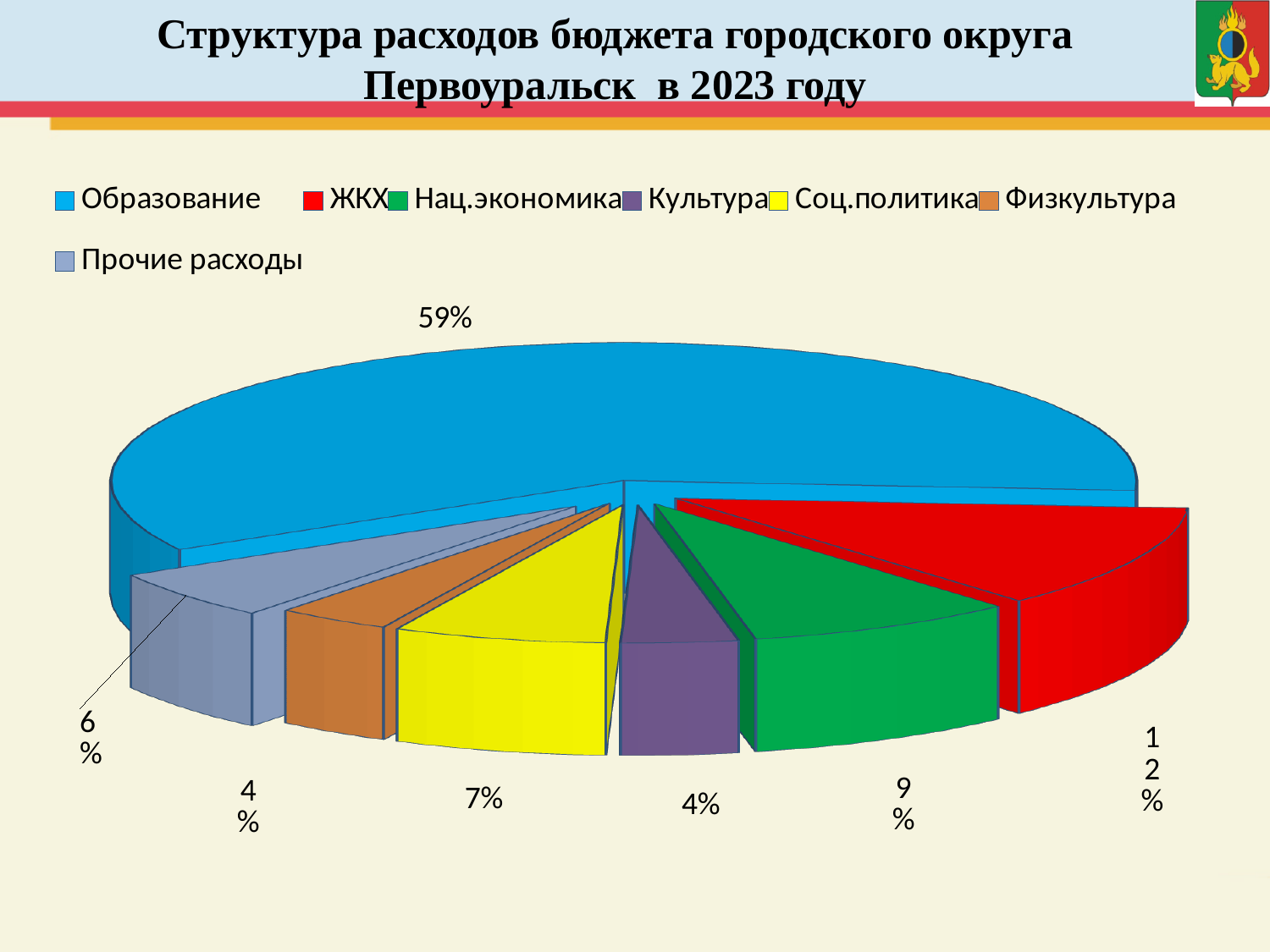
What share of the budget expenditure goes to Соц.политика? 7% How many categories does the legend list? 7 What share of the budget expenditure goes to Образование? 59% Which colour represents Культура in the chart? purple What is the difference in percentage points between the shares of Образование and ЖКХ? 47 What share of the budget expenditure goes to ЖКХ? 12% What is the title of the slide? Структура расходов бюджета городского округа Первоуральск в 2023 году Which has a larger share, Нац.экономика or Соц.политика? Нац.экономика Which category has the largest share of the budget expenditure? Образование What kind of chart is shown on the slide? pie chart